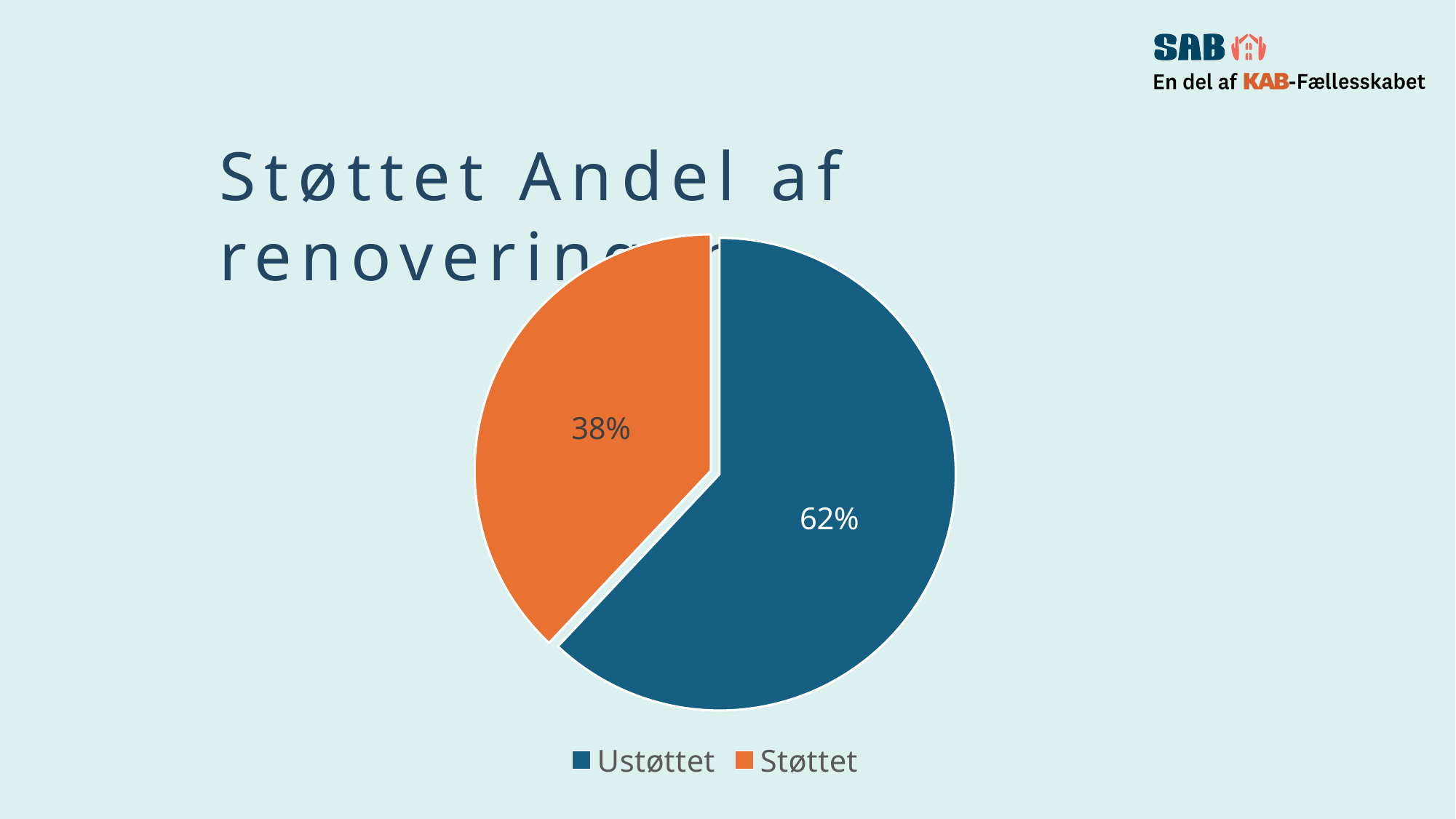
Which slice is the largest? Ustøttet Which is larger, Ustøttet or Støttet? Ustøttet How many entries does the legend list? 2 What share of the pie does Ustøttet represent? 62% Which slice is the smallest? Støttet What is the difference in percentage points between Ustøttet and Støttet? 24 What share of the pie does Støttet represent? 38% How many slices does the pie chart have? 2 What colour is the Ustøttet slice? dark blue What type of chart is shown on the slide? pie chart What colour is the Støttet slice? orange